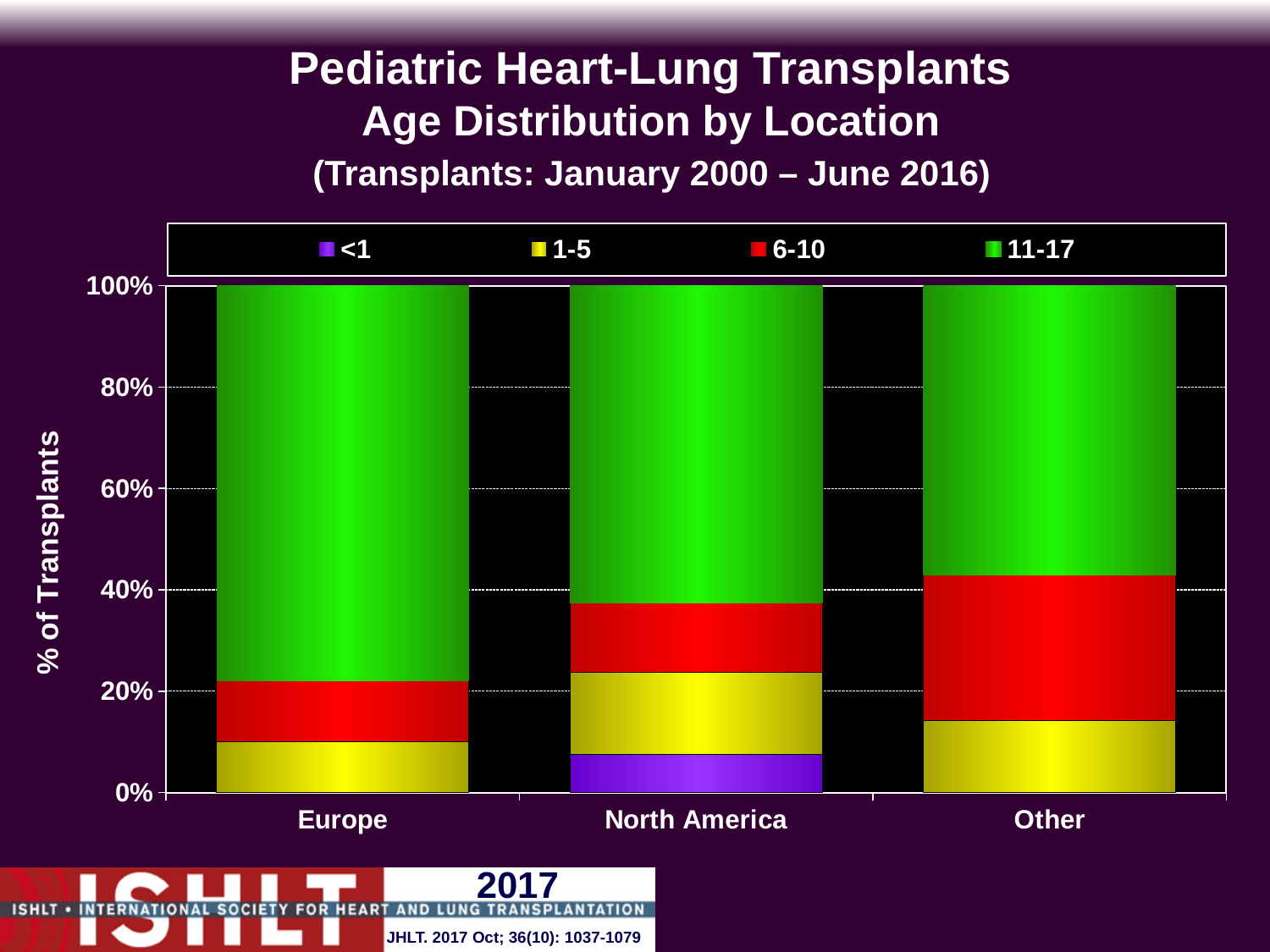
Which location is the only one with a visible <1 age group segment? North America Is the share of the 6-10 age group for Other greater or less than 20%? greater How many age groups does the legend list? 4 Is the share of the <1 age group for North America greater or less than 20%? less Which location has the largest share of transplants in the 11-17 age group? Europe Which is larger: the 11-17 share for Europe or the 11-17 share for Other? Europe What kind of chart is shown on the slide? Stacked bar chart What is the label on the y axis? % of Transplants Is the share of the 1-5 age group for Europe greater or less than 20%? less Which location has the largest share of transplants in the 6-10 age group? Other How many locations are shown on the x axis? 3